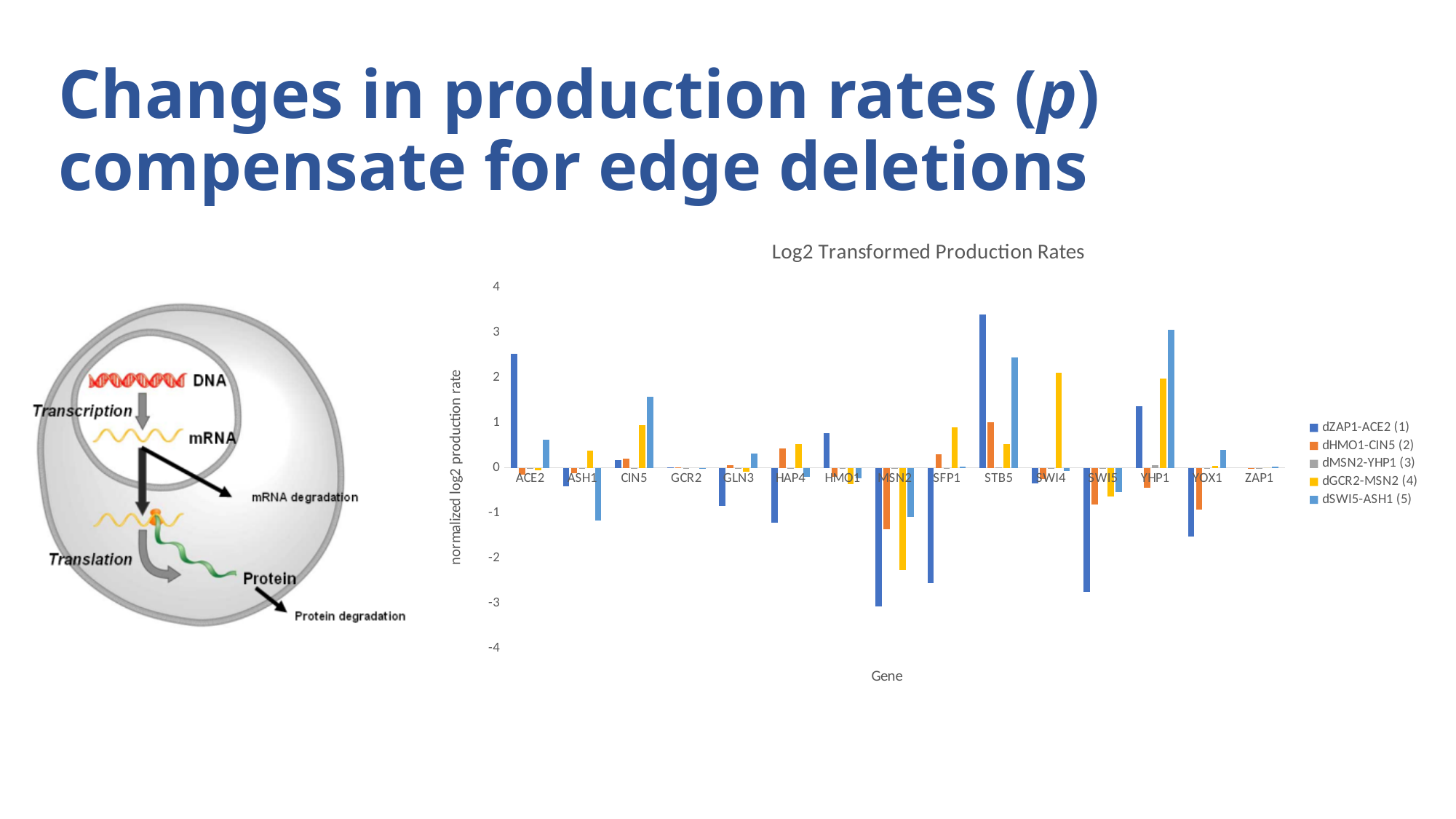
How many genes are shown along the x axis of the chart? 15 Is the dZAP1-ACE2 (1) value for SWI5 greater or less than -2? less What is the label of the y axis of the chart? normalized log2 production rate What is the title of the chart? Log2 Transformed Production Rates For the gene ACE2, which series has the larger value: dZAP1-ACE2 (1) or dSWI5-ASH1 (5)? dZAP1-ACE2 (1) How many series does the chart legend list? 5 What type of chart is shown on the slide? bar chart Is the dZAP1-ACE2 (1) value for ACE2 greater or less than 2? greater Is the dSWI5-ASH1 (5) value for STB5 greater or less than 2? greater For which gene does the dZAP1-ACE2 (1) series reach its highest value? STB5